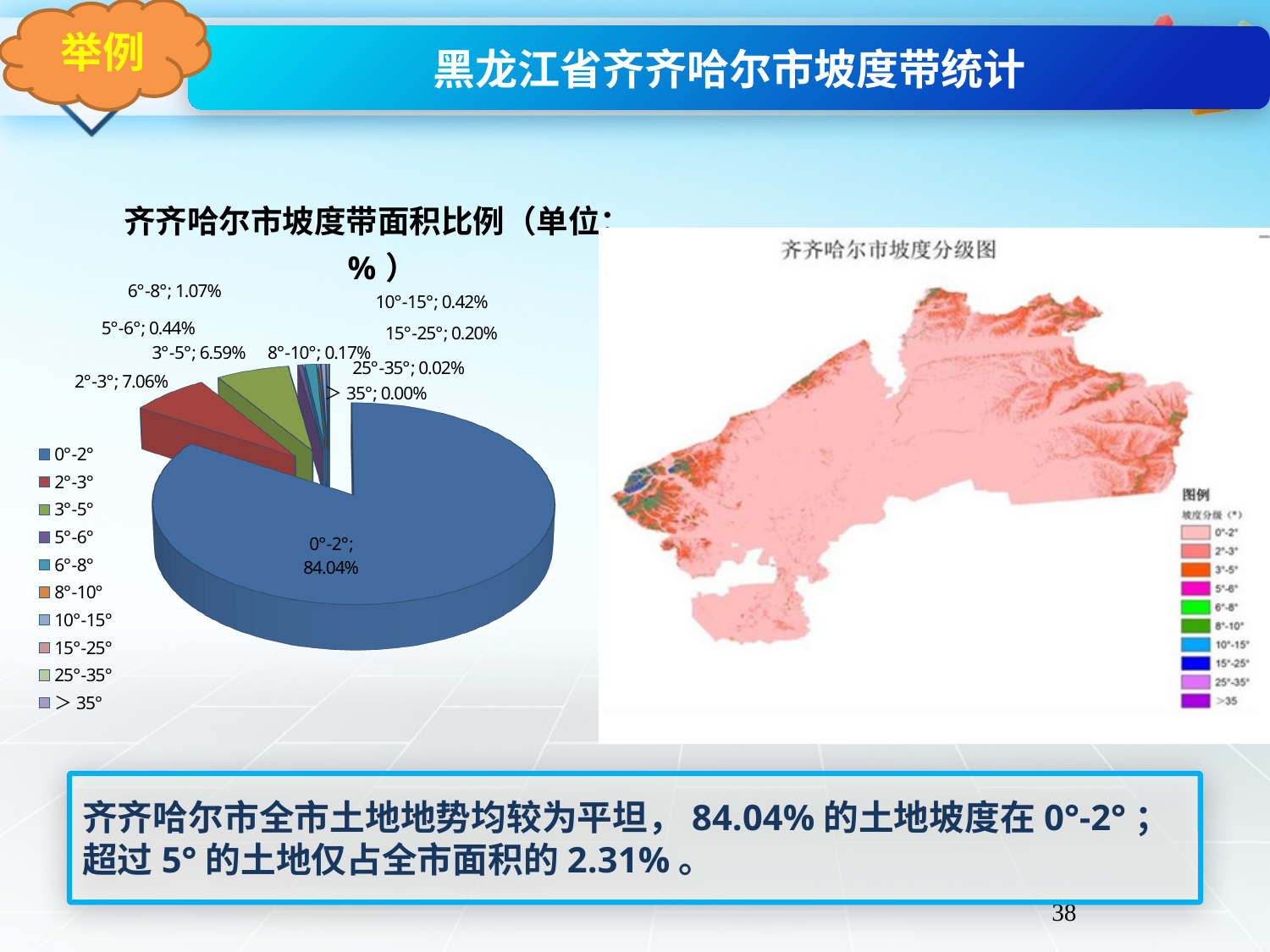
Which is larger in the pie chart, the value for 10°-15° or the value for 15°-25°? 10°-15° What type of chart is shown on the slide? pie chart Which slope band has the smallest share of the pie chart? > 35° What is the difference between the values for the 2°-3° and 3°-5° slope bands? 0.47% What is the value for the 25°-35° slope band in the pie chart? 0.02% What is the title of the pie chart? 齐齐哈尔市坡度带面积比例（单位：%） What is the value for the 0°-2° slope band in the pie chart? 84.04% What is the value for the 2°-3° slope band in the pie chart? 7.06% Which slope band has the largest share of the pie chart? 0°-2° How many slope bands are listed in the pie chart's legend? 10 What is the value for the 6°-8° slope band in the pie chart? 1.07% What is the value for the 3°-5° slope band in the pie chart? 6.59%